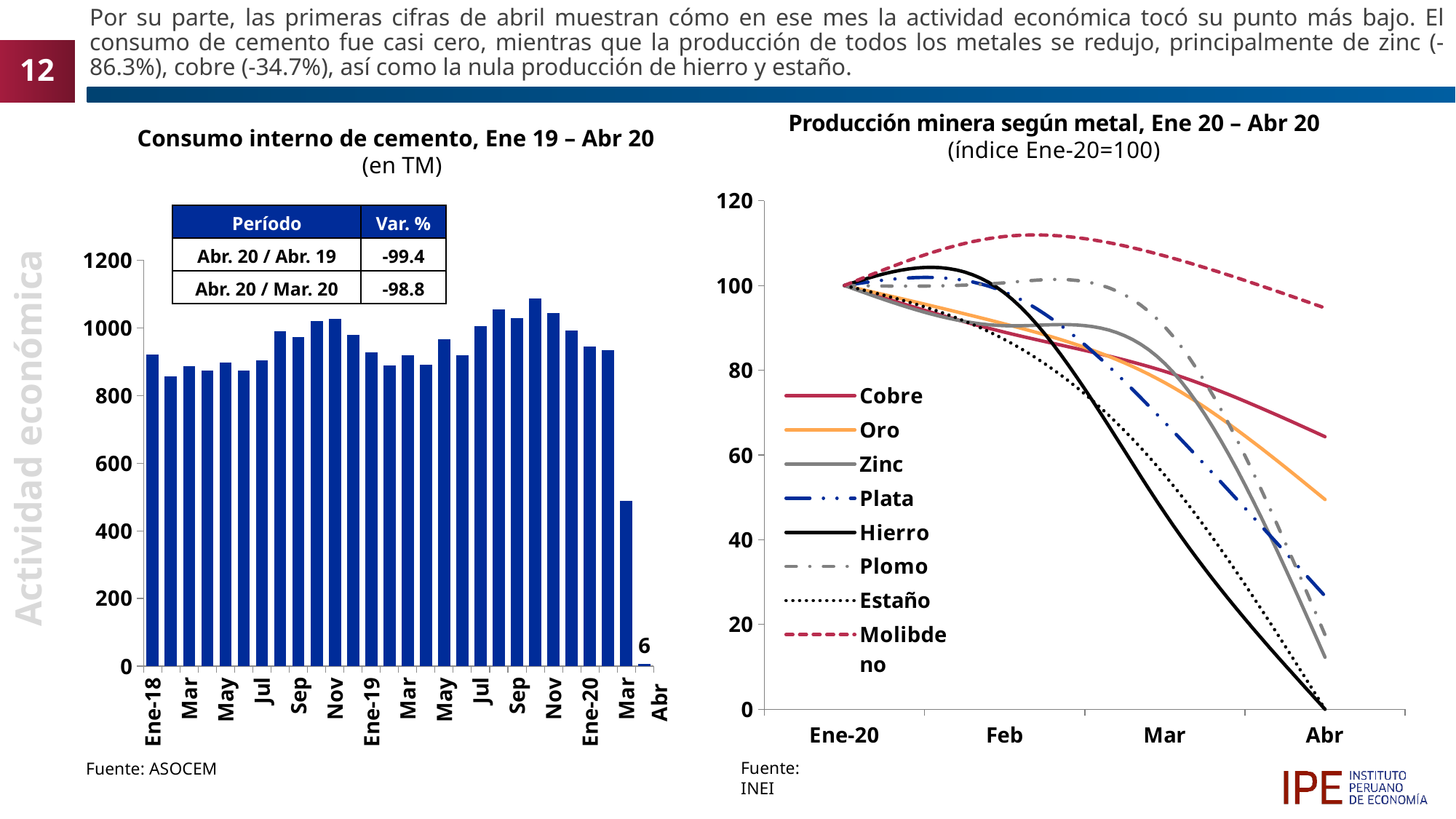
What kind of chart is 'Producción minera según metal, Ene 20 – Abr 20'? Line chart How many series does the legend of 'Producción minera según metal' list? 8 In the 'Producción minera según metal' chart, how many months are shown on the x axis? 4 In the 'Consumo interno de cemento' chart, which month has the lowest bar? Abr (2020) What kind of chart is 'Consumo interno de cemento, Ene 19 – Abr 20'? Bar chart In the 'Producción minera según metal' chart, does the Hierro line rise or fall from Feb to Abr? Falls In the 'Consumo interno de cemento' chart, what is the value shown for Abr 2020? 6 In the 'Consumo interno de cemento' chart, what is the Var. % shown in the table for Abr. 20 / Abr. 19? -99.4 In the 'Producción minera según metal' chart, is the value for Cobre in Abr greater or less than 60? greater In the 'Producción minera según metal' chart, which metal has the highest index in Abr? Molibdeno In the 'Consumo interno de cemento' chart, which month has the highest bar? Oct (2019) In the 'Consumo interno de cemento' chart, is the value for Mar 2020 greater or less than 600? less